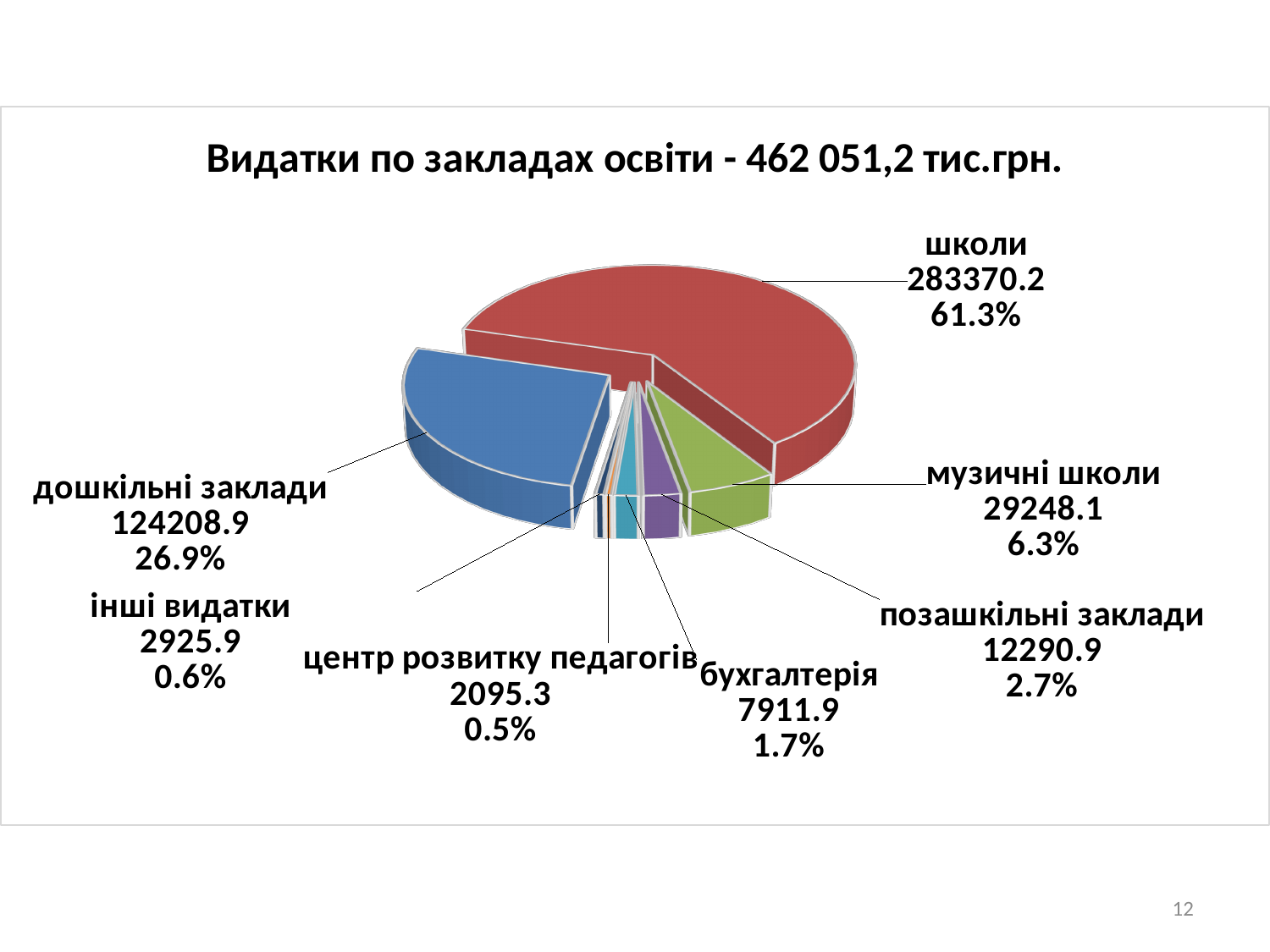
What is the title of the chart? Видатки по закладах освіти - 462 051,2 тис.грн. What is the value shown for музичні школи? 29248.1 Which is larger, the value for позашкільні заклади or the value for бухгалтерія? позашкільні заклади What percentage share is shown for бухгалтерія? 1.7% What kind of chart is shown on the slide? pie chart What percentage share is shown for дошкільні заклади? 26.9% What is the difference between the values for музичні школи and позашкільні заклади? 16957.2 How many categories are shown in the pie chart? 7 What is the difference between the values for школи and дошкільні заклади? 159161.3 What is the value shown for школи? 283370.2 Which category has the largest slice of the pie? школи Which category has the smallest slice of the pie? центр розвитку педагогів